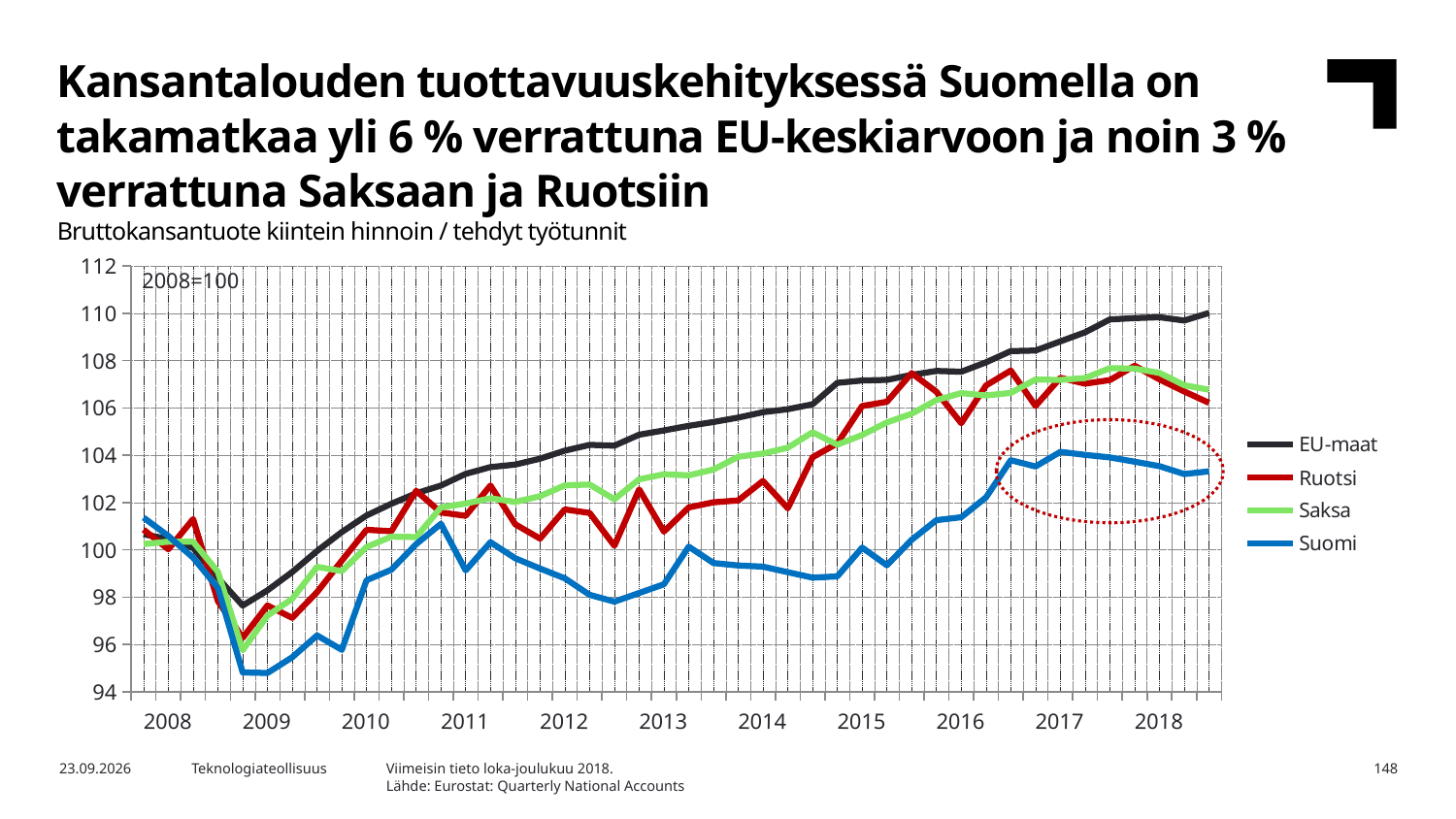
Which series has the lowest value at the end of 2018? Suomi What kind of chart is shown on the slide? Line chart Which series has the highest value at the end of 2018? EU-maat Which series are listed in the legend? EU-maat, Ruotsi, Saksa, Suomi What colour is the Suomi line? Blue Is the value for EU-maat at the end of 2018 greater or less than 108? greater At the end of 2018, which is larger, the value for EU-maat or the value for Suomi? EU-maat Is the lowest value for Suomi in 2009 greater or less than 96? less Is the value for Ruotsi at the end of 2018 greater or less than 104? greater Does the EU-maat series rise or fall overall from 2009 to 2018? Rise How many series does the legend list? 4